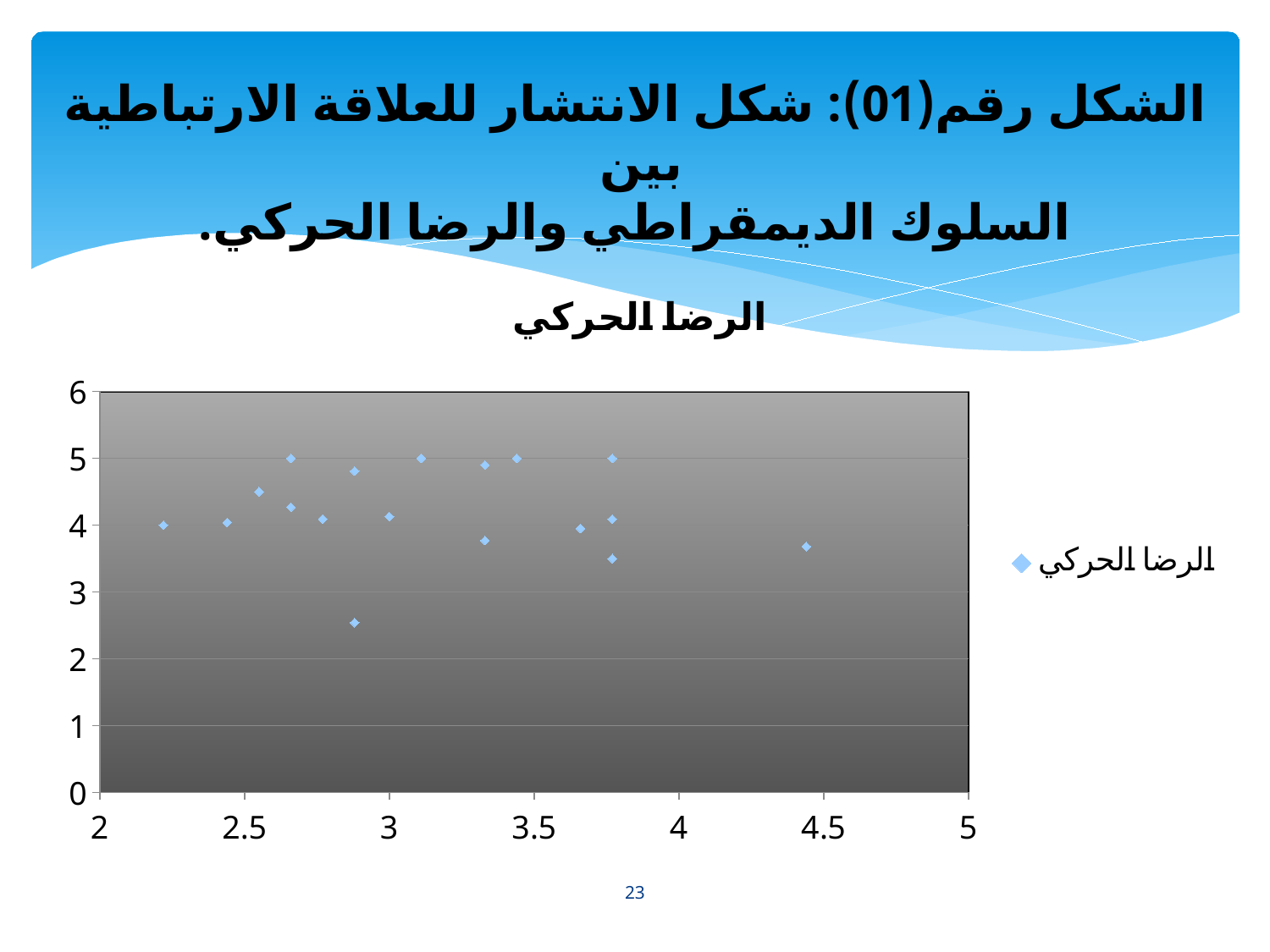
Which is larger on the vertical axis: the lowest point near 2.9 on the horizontal axis or the rightmost point near 4.5? the rightmost point near 4.5 What is the legend entry of the chart? الرضا الحركي Are any points on the chart above 5 on the vertical axis? No Is the point at about 2.9 on the horizontal axis with the lowest value greater or less than 2 on the vertical axis? greater How many series does the legend list? 1 Is the rightmost point on the chart (near 4.5 on the horizontal axis) greater or less than 4 on the vertical axis? less What kind of chart is shown on the slide? scatter chart What is the title of the chart? الرضا الحركي